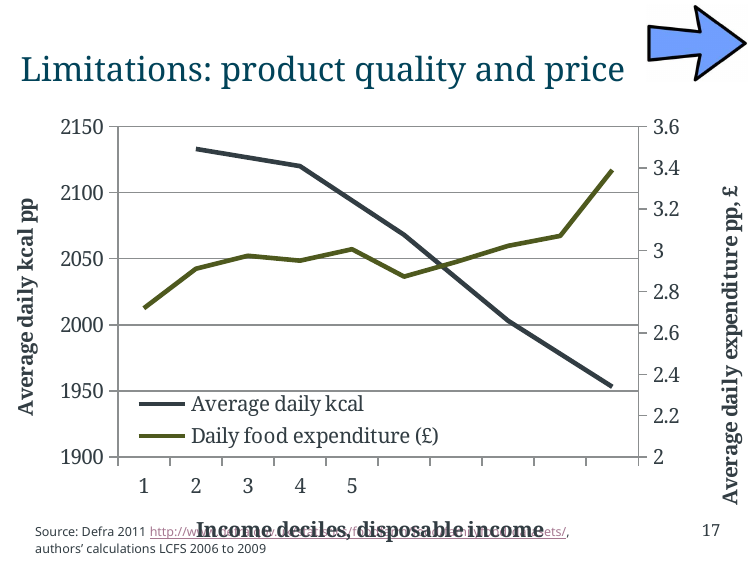
Which is larger for Daily food expenditure (£): the value at income decile 1 or the value at income decile 3? income decile 3 Does the Daily food expenditure (£) line generally rise or fall as income decile increases? rise What is the label of the x axis? Income deciles, disposable income Which is larger for Average daily kcal: the value at income decile 2 or the value at income decile 4? income decile 2 Is the Average daily kcal value at income decile 4 greater or less than 2100? greater Does the Average daily kcal line rise or fall as income decile increases? fall What kind of chart is shown on the slide? line chart Is the Daily food expenditure (£) value at the rightmost point of the line greater or less than 3.2? greater How many series does the legend list? 2 What are the two series named in the legend? Average daily kcal; Daily food expenditure (£) Is the Daily food expenditure (£) value at income decile 1 greater or less than 2.8? less